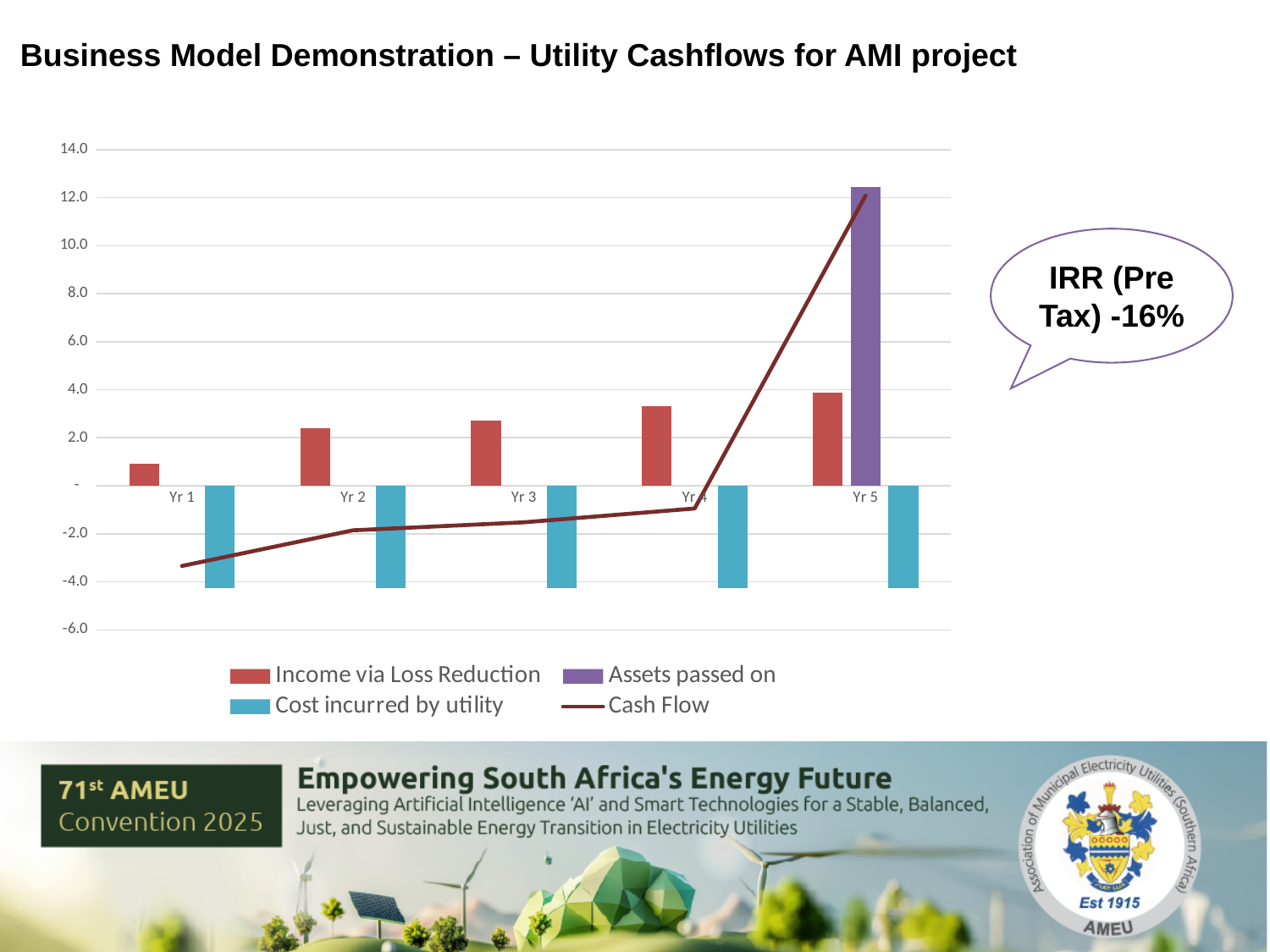
Is the value for Income via Loss Reduction in Yr 1 greater or less than 2.0? less In which year does the Assets passed on bar appear? Yr 5 How many year categories are shown on the x axis? 5 Does Income via Loss Reduction rise or fall from Yr 1 to Yr 5? Rise What kind of chart is shown on the slide? A combined bar and line chart Which is larger, Income via Loss Reduction in Yr 5 or in Yr 1? Yr 5 In which year is the Income via Loss Reduction bar lowest? Yr 1 Is the Cash Flow value in Yr 5 greater or less than 10.0? greater In which year is the Income via Loss Reduction bar highest? Yr 5 Is the value for Assets passed on in Yr 5 greater or less than 12.0? greater What IRR (Pre Tax) value is shown in the callout next to the chart? -16% How many series does the legend list? 4